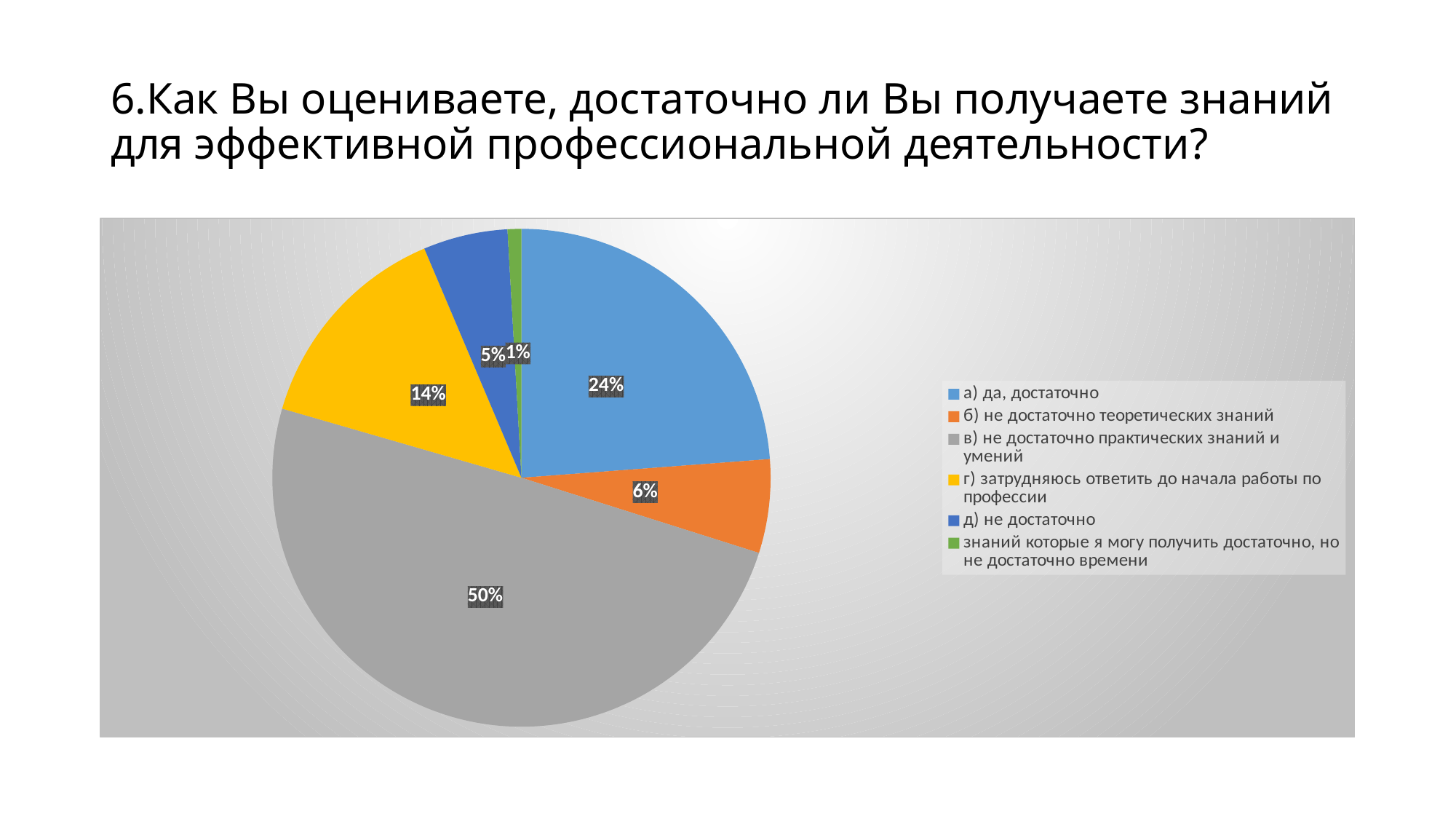
Which is larger: the share for "г) затрудняюсь ответить до начала работы по профессии" or the share for "б) не достаточно теоретических знаний"? г) затрудняюсь ответить до начала работы по профессии What is the difference between the shares for "в) не достаточно практических знаний и умений" and "а) да, достаточно"? 26% Which category has the largest slice of the pie? в) не достаточно практических знаний и умений What colour is the slice for "г) затрудняюсь ответить до начала работы по профессии"? yellow What share of the pie does "а) да, достаточно" have? 24% What share of the pie does "в) не достаточно практических знаний и умений" have? 50% Which category has the smallest slice of the pie? знаний которые я могу получить достаточно, но не достаточно времени How many categories does the legend list? 6 What share of the pie does "г) затрудняюсь ответить до начала работы по профессии" have? 14% What kind of chart is shown on the slide? pie chart